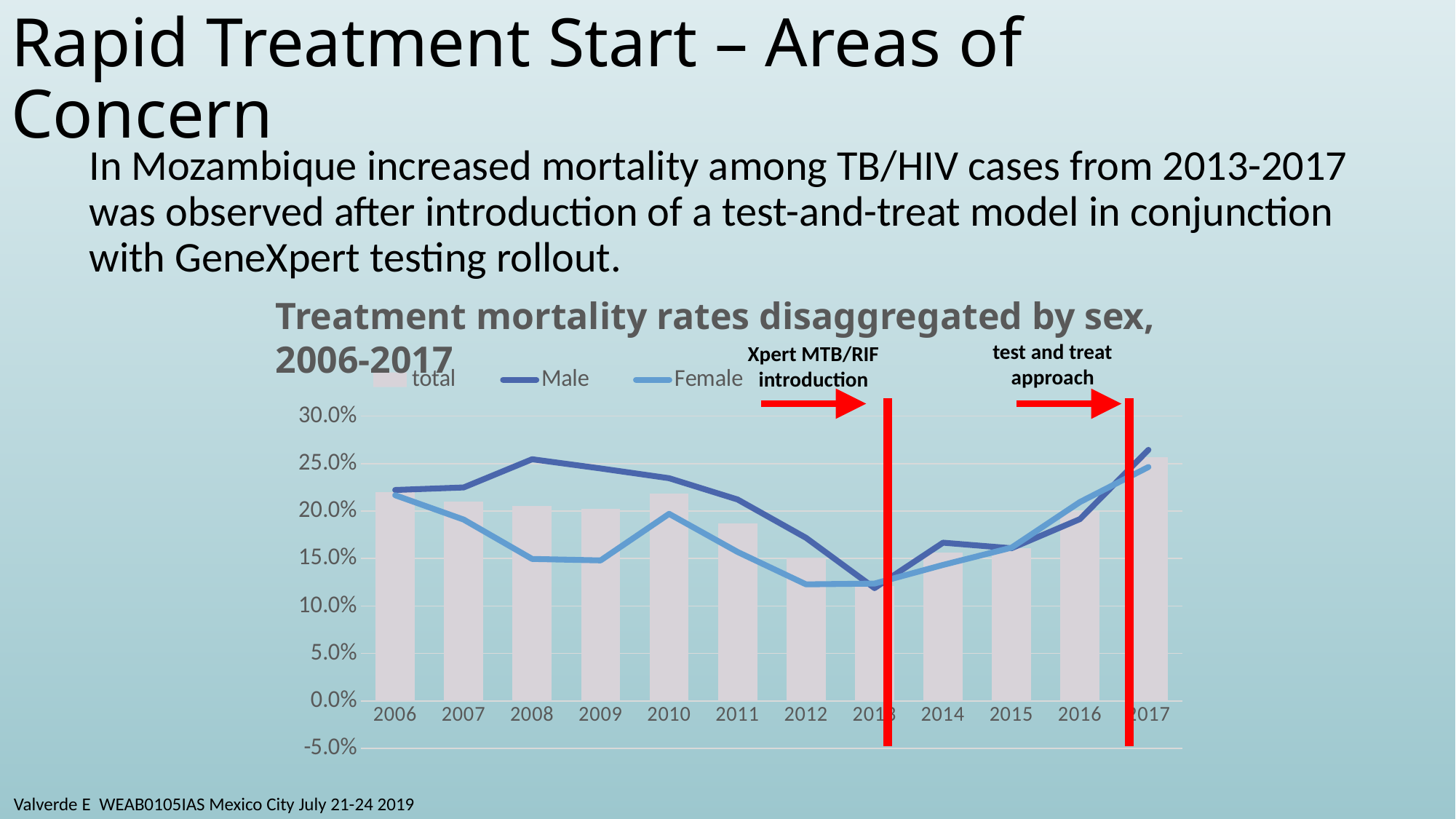
Which year has the highest total mortality rate bar? 2017 Is the Male mortality rate for 2011 greater or less than 20.0%? greater Is the total mortality rate for 2013 greater or less than 15.0%? less In which year is the Male mortality rate lowest? 2013 What is the title of the chart? Treatment mortality rates disaggregated by sex, 2006-2017 How many years are shown on the x axis of the chart? 12 How many series does the chart legend list? 3 Is the Female mortality rate for 2012 greater or less than 15.0%? less What kind of chart is this? Combined bar and line chart In 2008, which is higher, the Male or the Female mortality rate? Male Does the Female mortality rate rise or fall from 2013 to 2017? rise Which year has the lowest total mortality rate bar? 2013